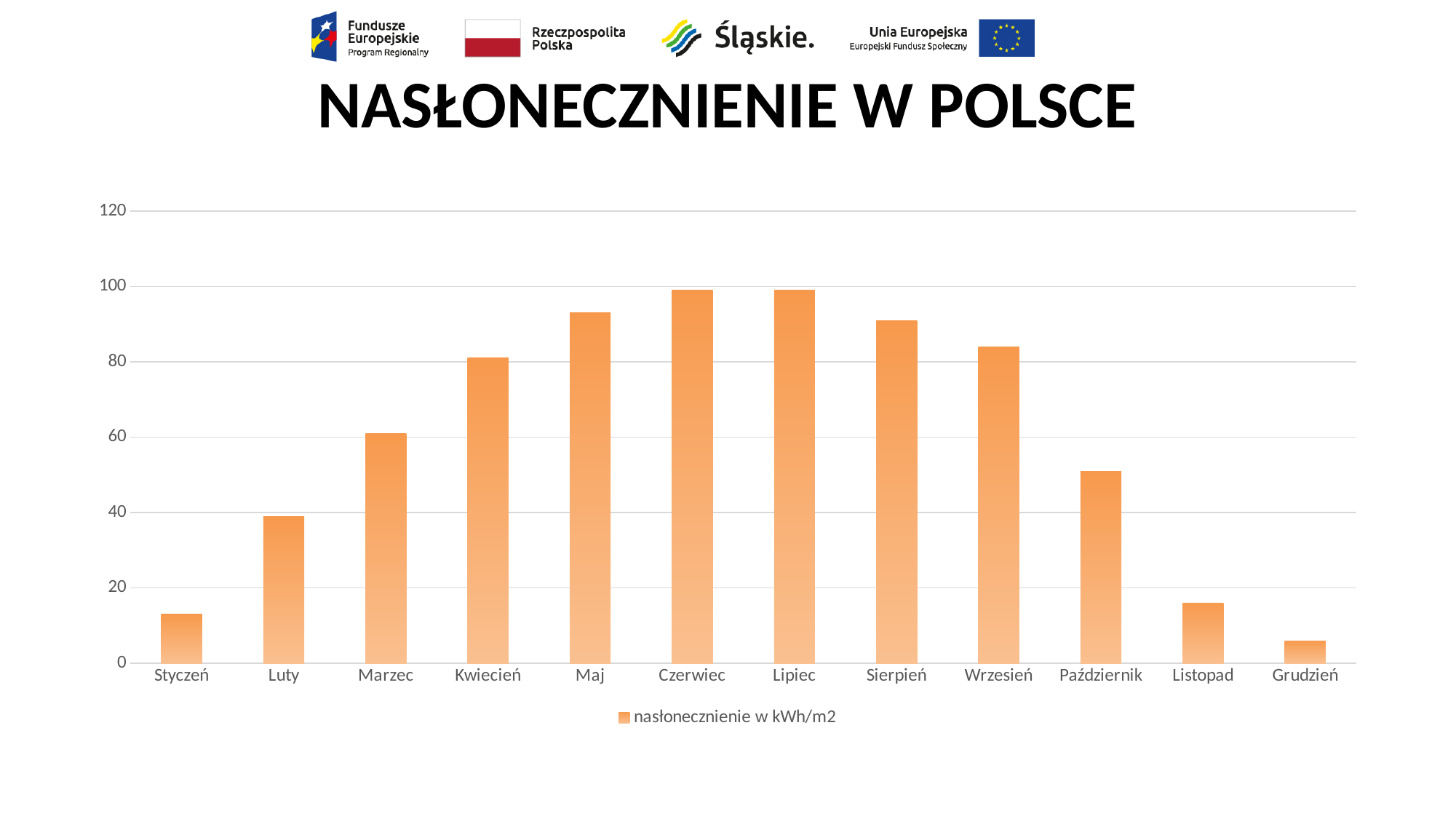
What is the legend entry for the plotted series? nasłonecznienie w kWh/m2 Which is larger, the value for Luty or the value for Październik? Październik Which month has the lowest value? Grudzień Is the value for Maj greater or less than 80? greater Is the value for Październik greater or less than 40? greater Is the value for Styczeń greater or less than 20? less What is the title of the chart? NASŁONECZNIENIE W POLSCE Do the values rise or fall from Lipiec to Grudzień? fall How many months (categories) are plotted on the x axis? 12 How many series does the legend list? 1 What kind of chart is shown on the slide? bar chart